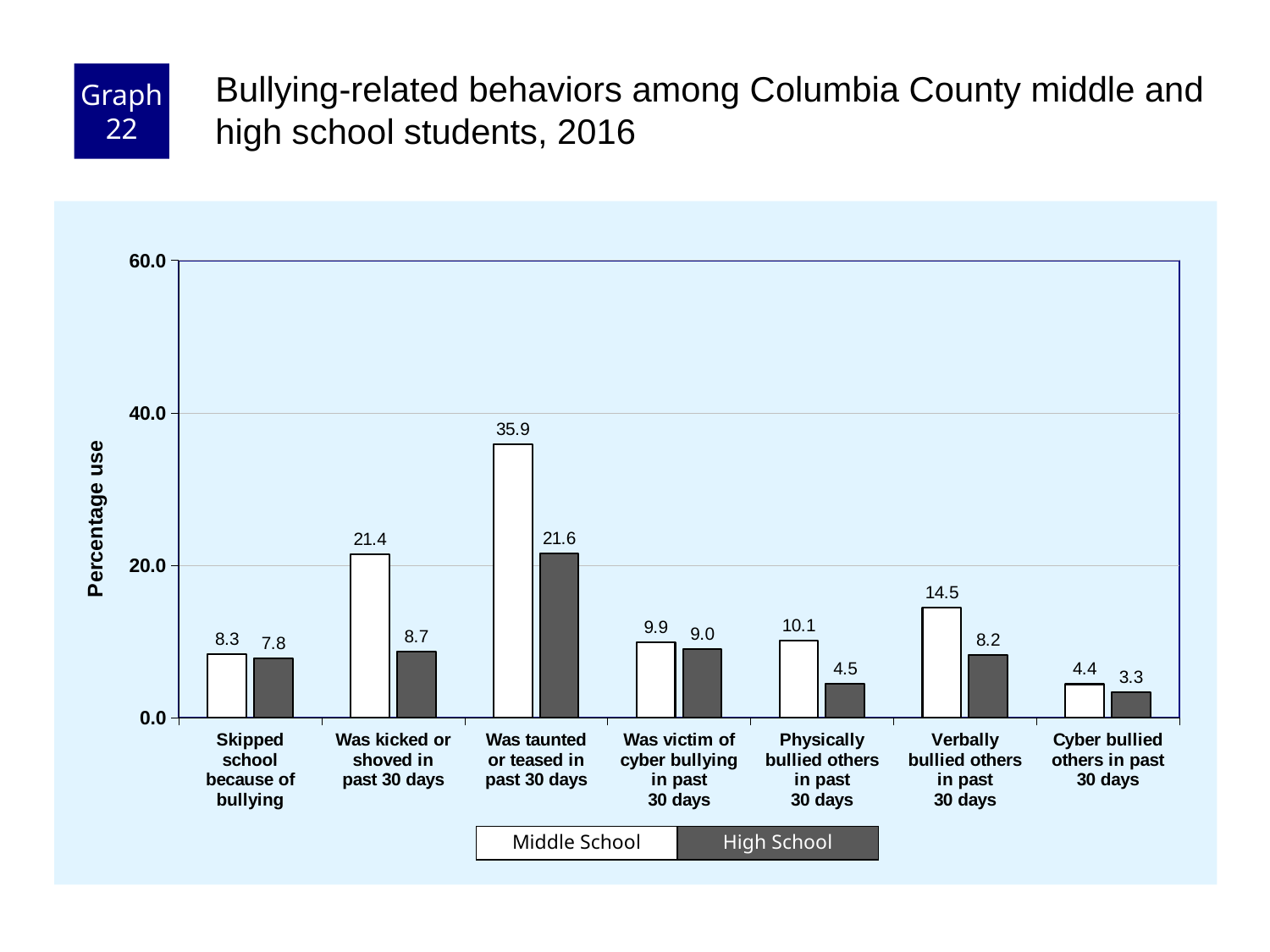
What kind of chart is shown on the slide? Bar chart How many categories are shown on the x axis? 7 What is the difference between the Middle School and High School values for 'Verbally bullied others in past 30 days'? 6.3 What is the Middle School value for 'Was taunted or teased in past 30 days'? 35.9 Is the Middle School value for 'Was kicked or shoved in past 30 days' greater or less than 20.0? greater What is the difference between the Middle School and High School values for 'Was taunted or teased in past 30 days'? 14.3 What is the High School value for 'Physically bullied others in past 30 days'? 4.5 How many series does the legend list? 2 Which category has the highest Middle School value? Was taunted or teased in past 30 days Which category has the lowest High School value? Cyber bullied others in past 30 days Which is larger for 'Skipped school because of bullying': the Middle School value or the High School value? Middle School What is the High School value for 'Was kicked or shoved in past 30 days'? 8.7